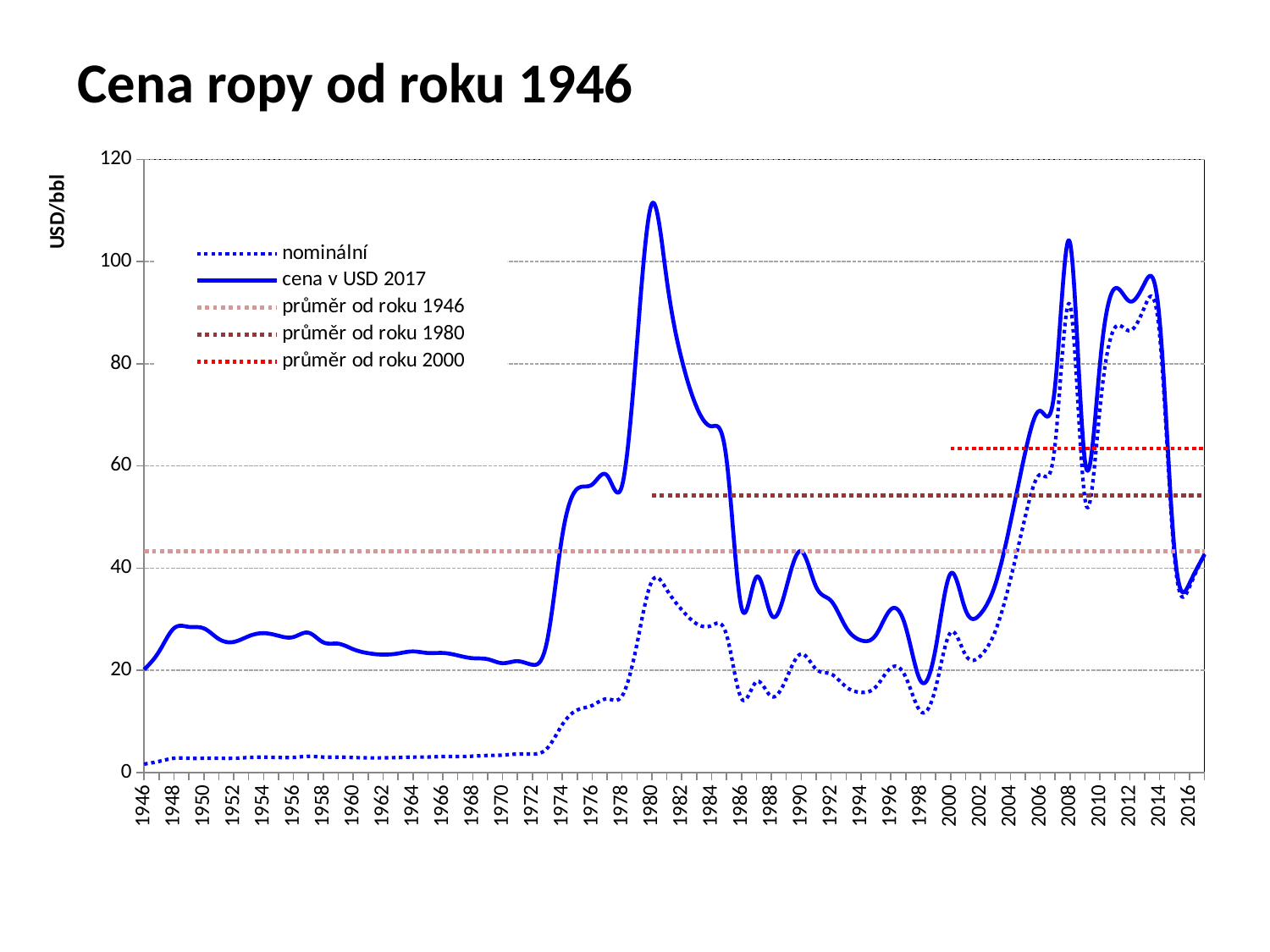
Is the line 'průměr od roku 2000' greater or less than 60? greater Between 1980 and 1986, does 'cena v USD 2017' rise or fall? fall Is the value of 'cena v USD 2017' in 1980 greater or less than 100? greater What is the title of the chart? Cena ropy od roku 1946 In which year does 'cena v USD 2017' reach its highest value? 1980 What is the label on the vertical axis? USD/bbl Is the value of 'cena v USD 2017' in 1974 greater or less than 40? greater How many series does the legend list? 5 What kind of chart is shown on the slide? line chart Which is higher, 'průměr od roku 2000' or 'průměr od roku 1980'? průměr od roku 2000